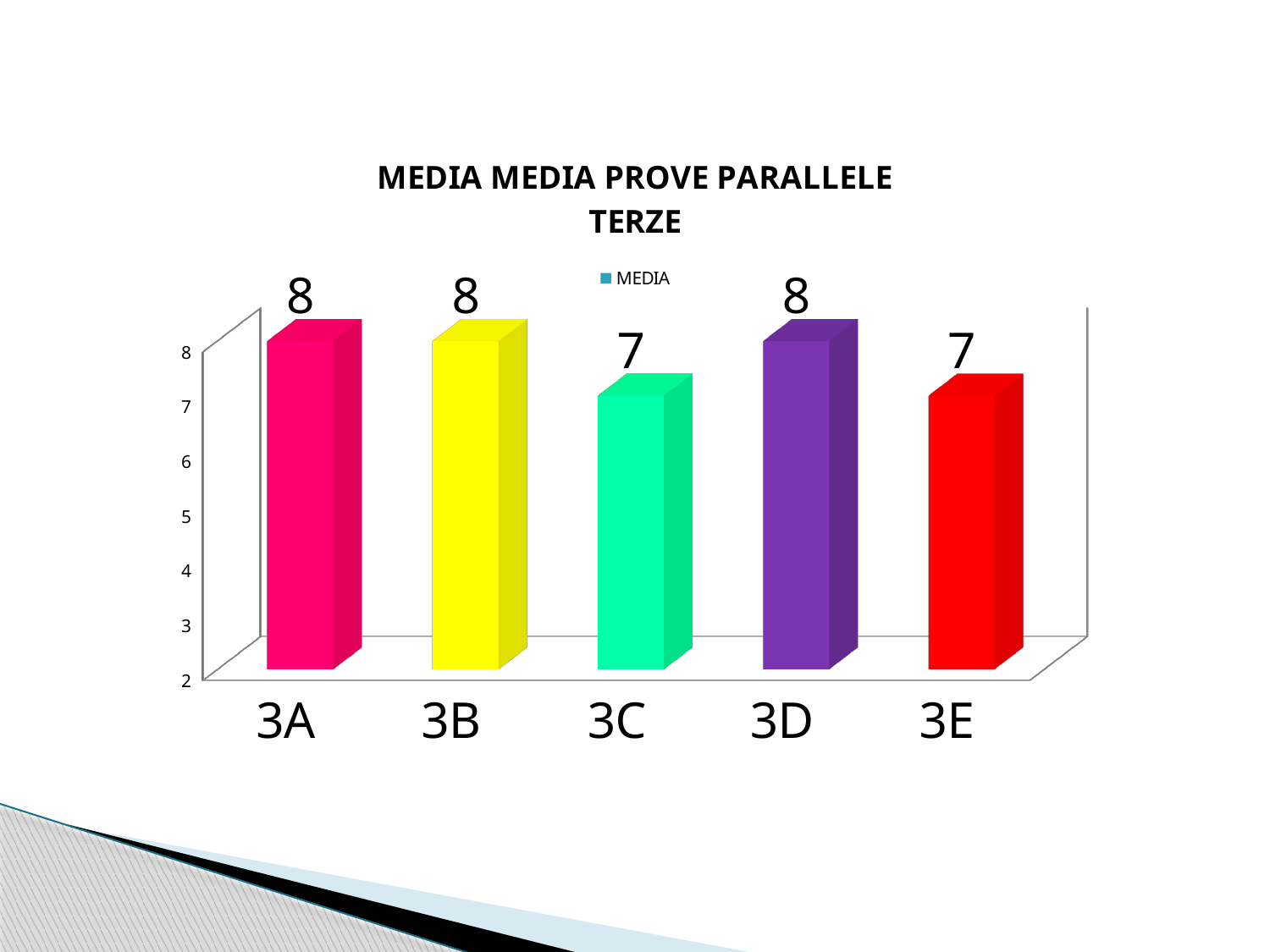
What kind of chart is shown? bar chart What is the difference between the values for 3B and 3C? 1 What is the value for 3C? 7 What is the name of the series listed in the legend? MEDIA Which is larger, the value for 3D or the value for 3E? 3D Is the value for 3C greater or less than 8? less How many series does the legend list? 1 What is the value for 3D? 8 What is the title of the chart? MEDIA MEDIA PROVE PARALLELE TERZE How many categories are shown on the x axis? 5 What is the value for 3A? 8 What is the value for 3E? 7